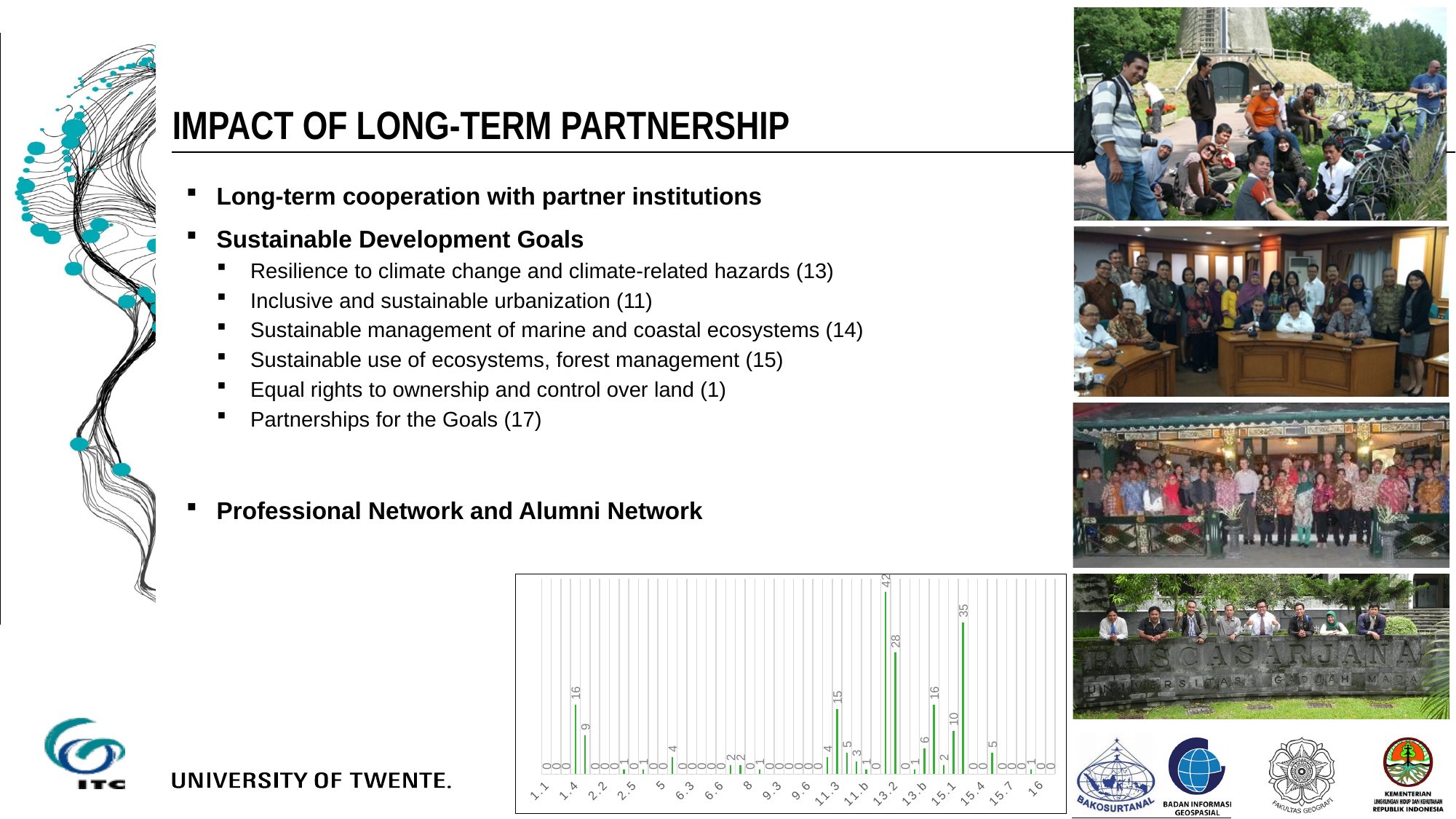
What is the last category label shown on the x axis of the bar chart? 16 How many data series are plotted on the bar chart? 1 What is the highest value labelled on the bar chart? 42 What kind of chart is shown at the bottom of the slide? bar chart What is the difference between the bar labelled 42 and the neighbouring bar labelled 28? 14 What is the first category label shown on the x axis of the bar chart? 1.1 What is the difference between the two tallest bars on the chart (42 and 35)? 7 What is the second-highest value labelled on the bar chart? 35 How many bars on the chart are labelled with the value 16? 2 What is the lowest value labelled on the bar chart? 0 Which is larger on the bar chart, the bar labelled 28 or the bar labelled 35? 35